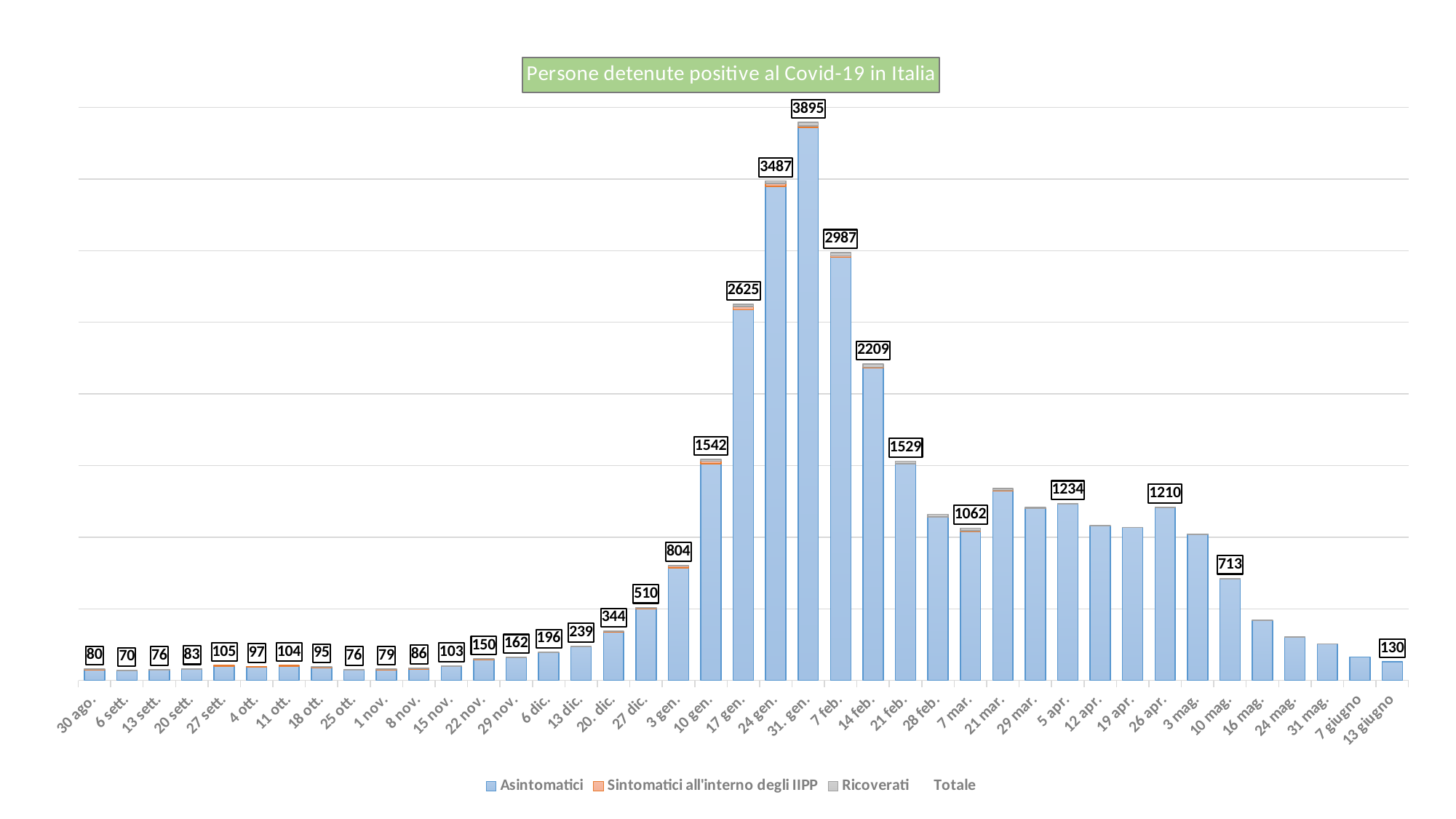
Which is larger, the total for 5 apr. or the total for 26 apr.? 5 apr. How many series does the legend list? 4 What is the difference between the totals for 31 gen. and 24 gen.? 408 What kind of chart is shown on the slide? bar chart What is the total value labelled for 13 giugno? 130 What is the total value labelled for 31 gen.? 3895 How many dates are shown on the x axis? 41 Which date has the lowest total? 6 sett. Do the totals rise or fall from 30 ago. to 31 gen.? rise What is the total value labelled for 10 gen.? 1542 What is the title of the chart? Persone detenute positive al Covid-19 in Italia Which date has the highest total? 31 gen.